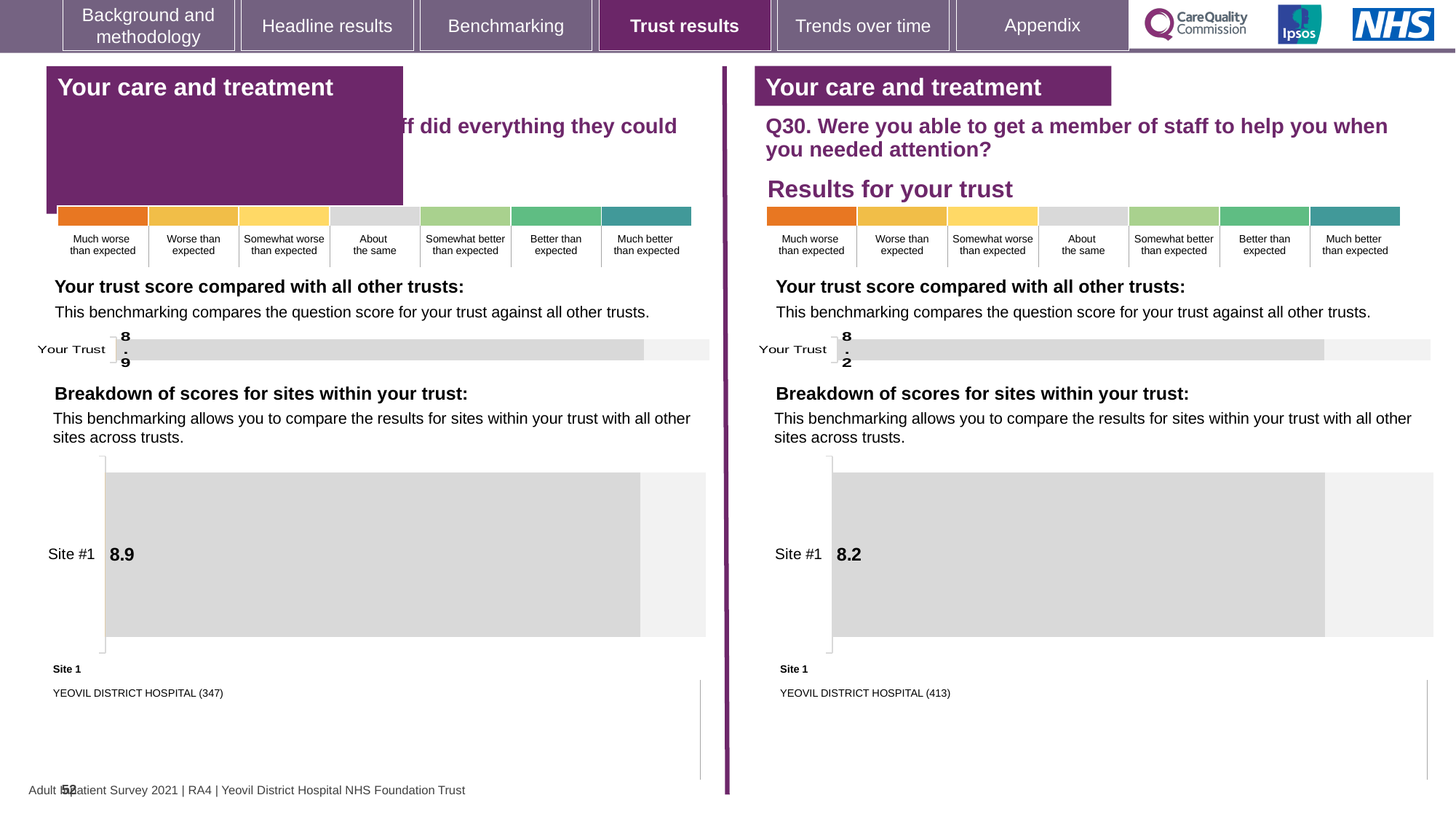
What is the difference between the Site #1 score on the left-hand chart and the Site #1 score on the right-hand chart (Q30)? 0.7 On the right-hand chart (Q30), what is the score shown for Site #1? 8.2 How many sites are shown in the breakdown of scores on the right-hand chart (Q30)? 1 What kind of chart is used to show the breakdown of scores for sites within your trust on the right-hand panel (Q30)? Bar chart How many sites are shown in the breakdown of scores on the left-hand chart? 1 On the right-hand panel (Q30), which hospital is listed as Site 1? YEOVIL DISTRICT HOSPITAL Which is larger: the Site #1 score on the left-hand chart or the Site #1 score on the right-hand chart (Q30)? Left-hand chart (8.9) On the left-hand chart, what is the score shown for Site #1? 8.9 On the right-hand chart (Q30), what is the score shown for Your Trust? 8.2 On the right-hand panel (Q30), what number appears in parentheses after YEOVIL DISTRICT HOSPITAL? 413 On the left-hand chart, what is the score shown for Your Trust? 8.9